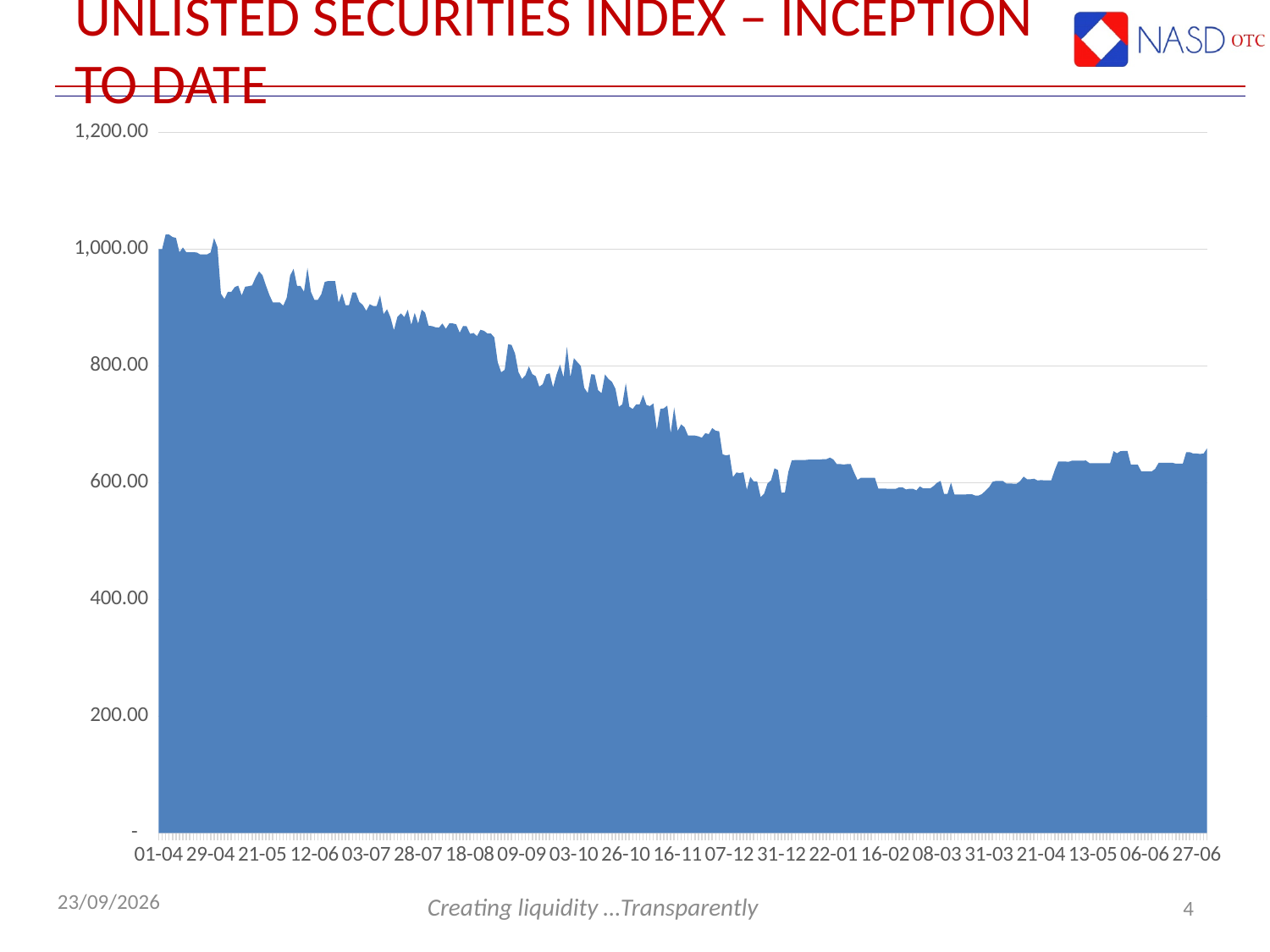
Is the value of the index at 12-06 greater or less than 800? greater How many date labels are shown along the x axis? 21 Is the value of the index at 31-03 greater or less than 800? less Is the value of the index at 01-04 greater or less than 800? greater At which labelled date on the x axis is the index at its highest? 01-04 Overall, does the index rise or fall from 01-04 to 27-06 along the x axis? fall What kind of chart is shown on the slide? area chart What is the highest value shown on the y axis? 1,200.00 Which is larger, the index value at 01-04 or at 27-06? 01-04 Which is larger, the index value at 03-07 or at 31-12? 03-07